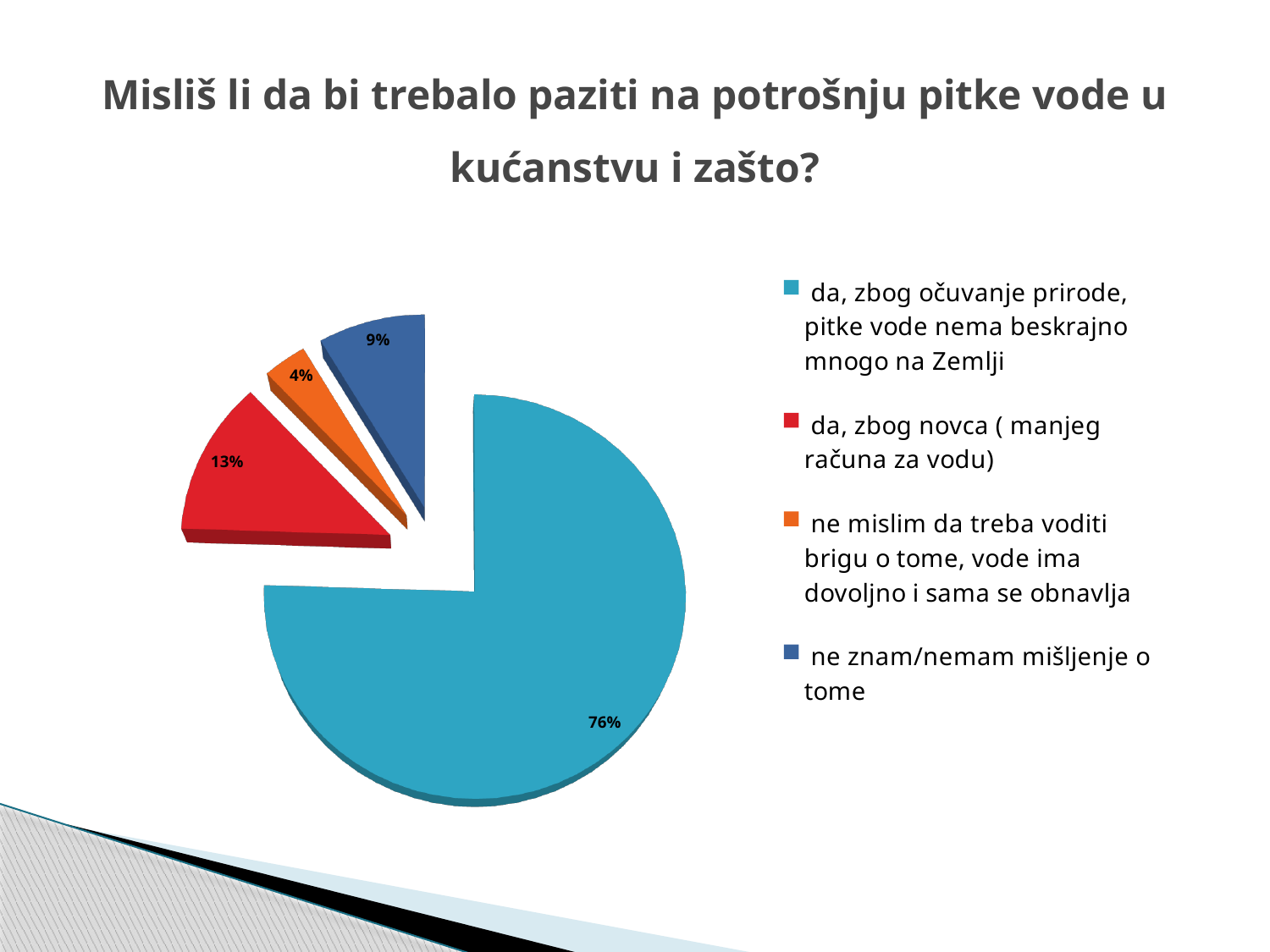
What share of the pie is labelled for "da, zbog novca ( manjeg računa za vodu)"? 13% What colour is the slice for "da, zbog novca ( manjeg računa za vodu)"? red What is the difference in percentage points between the "da, zbog novca" slice and the "ne znam/nemam mišljenje o tome" slice? 4 What share of the pie is labelled for "ne znam/nemam mišljenje o tome"? 9% Which is larger: the slice for "ne znam/nemam mišljenje o tome" or the slice for "ne mislim da treba voditi brigu o tome"? ne znam/nemam mišljenje o tome How many slices does the pie chart have? 4 How many entries does the legend list? 4 What share of the pie is labelled for "ne mislim da treba voditi brigu o tome, vode ima dovoljno i sama se obnavlja"? 4% What kind of chart is shown on the slide? pie chart Which category has the smallest slice of the pie? ne mislim da treba voditi brigu o tome, vode ima dovoljno i sama se obnavlja What share of the pie is labelled for "da, zbog očuvanje prirode, pitke vode nema beskrajno mnogo na Zemlji"? 76% Which category has the largest slice of the pie? da, zbog očuvanje prirode, pitke vode nema beskrajno mnogo na Zemlji